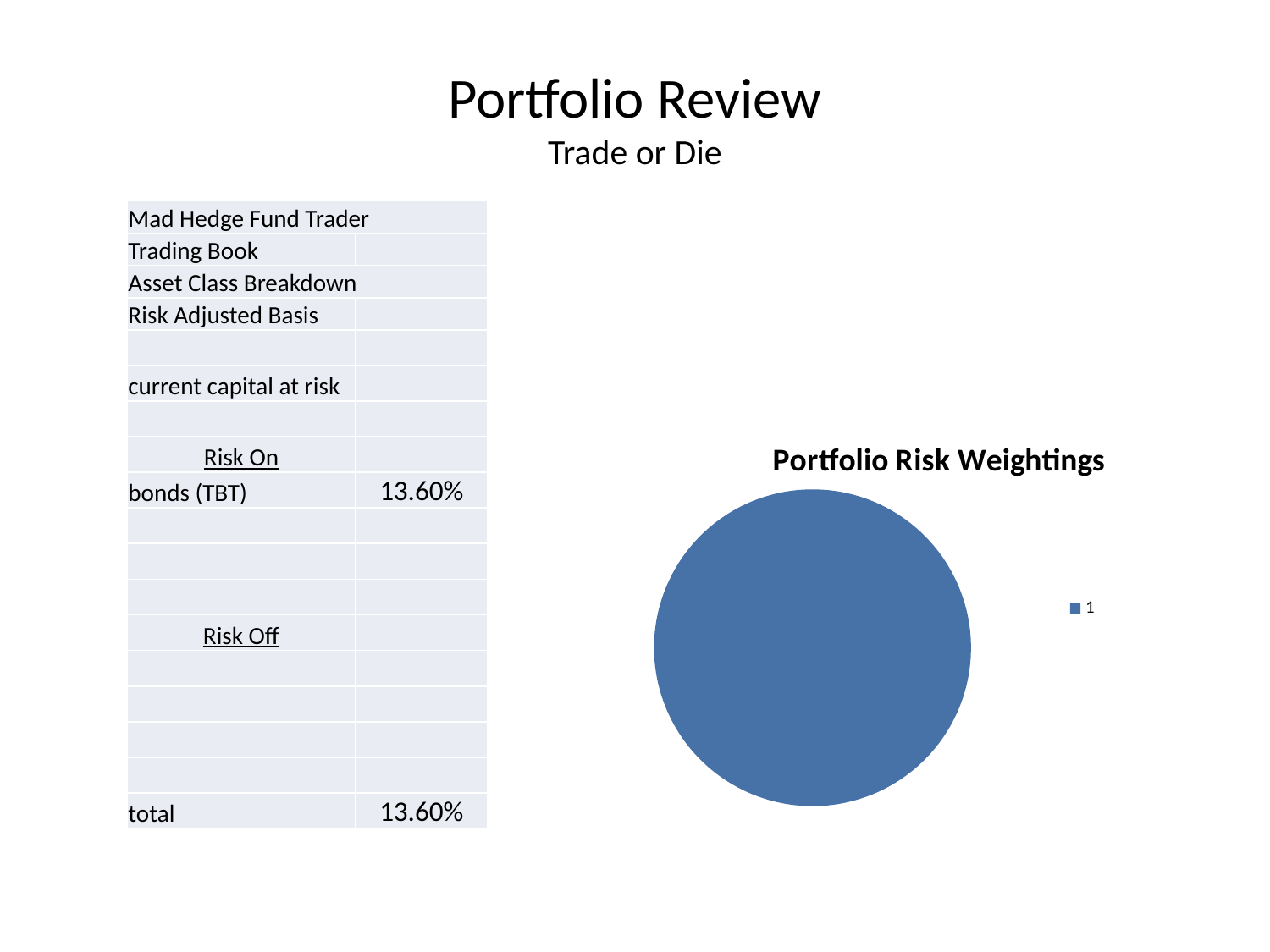
What share of the pie chart does the single slice take up? 100% What label does the legend of the pie chart show? 1 How many entries does the legend of the pie chart list? 1 How many slices does the pie chart have? 1 What is the title of the chart on the slide? Portfolio Risk Weightings What kind of chart is shown on the slide? pie chart